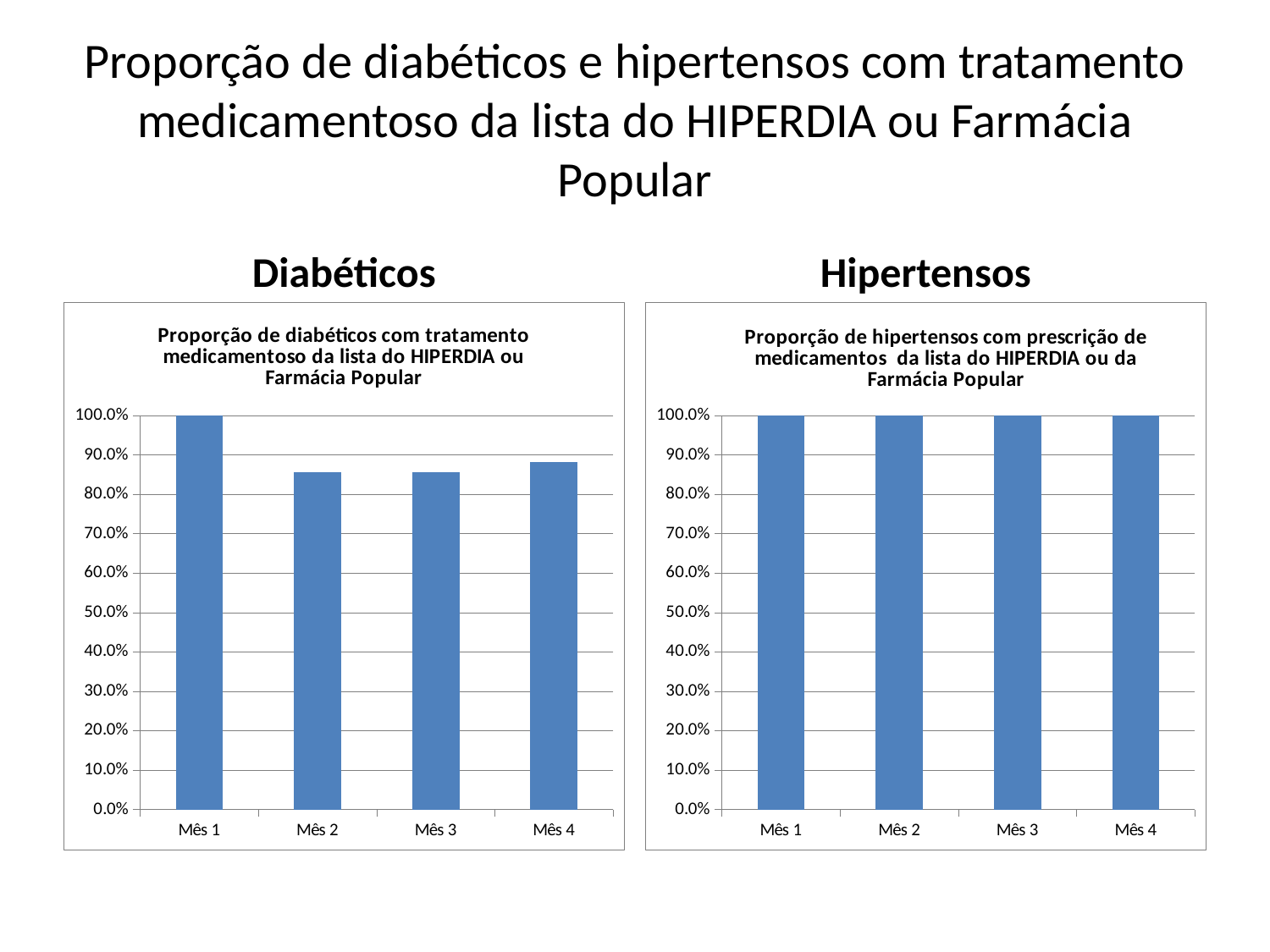
In the Diabéticos chart, which month has the highest value? Mês 1 How many months are shown on the x axis of the Hipertensos chart? 4 In the Hipertensos chart, do the values change from Mês 1 to Mês 4? No, they stay at 100.0% In the Diabéticos chart, which is larger, the value for Mês 1 or the value for Mês 3? Mês 1 In the Diabéticos chart, what is the value for Mês 1? 100.0% In the Diabéticos chart, does the value rise or fall from Mês 1 to Mês 2? fall What is the title of the chart on the right side of the slide? Proporção de hipertensos com prescrição de medicamentos da lista do HIPERDIA ou da Farmácia Popular In the Hipertensos chart, what is the value for Mês 3? 100.0% How many bars are plotted in the Diabéticos chart? 4 In the Diabéticos chart, is the value for Mês 2 greater or less than 80.0%? greater In the Diabéticos chart, is the value for Mês 4 greater or less than 90.0%? less What kind of chart is the Hipertensos chart? bar chart